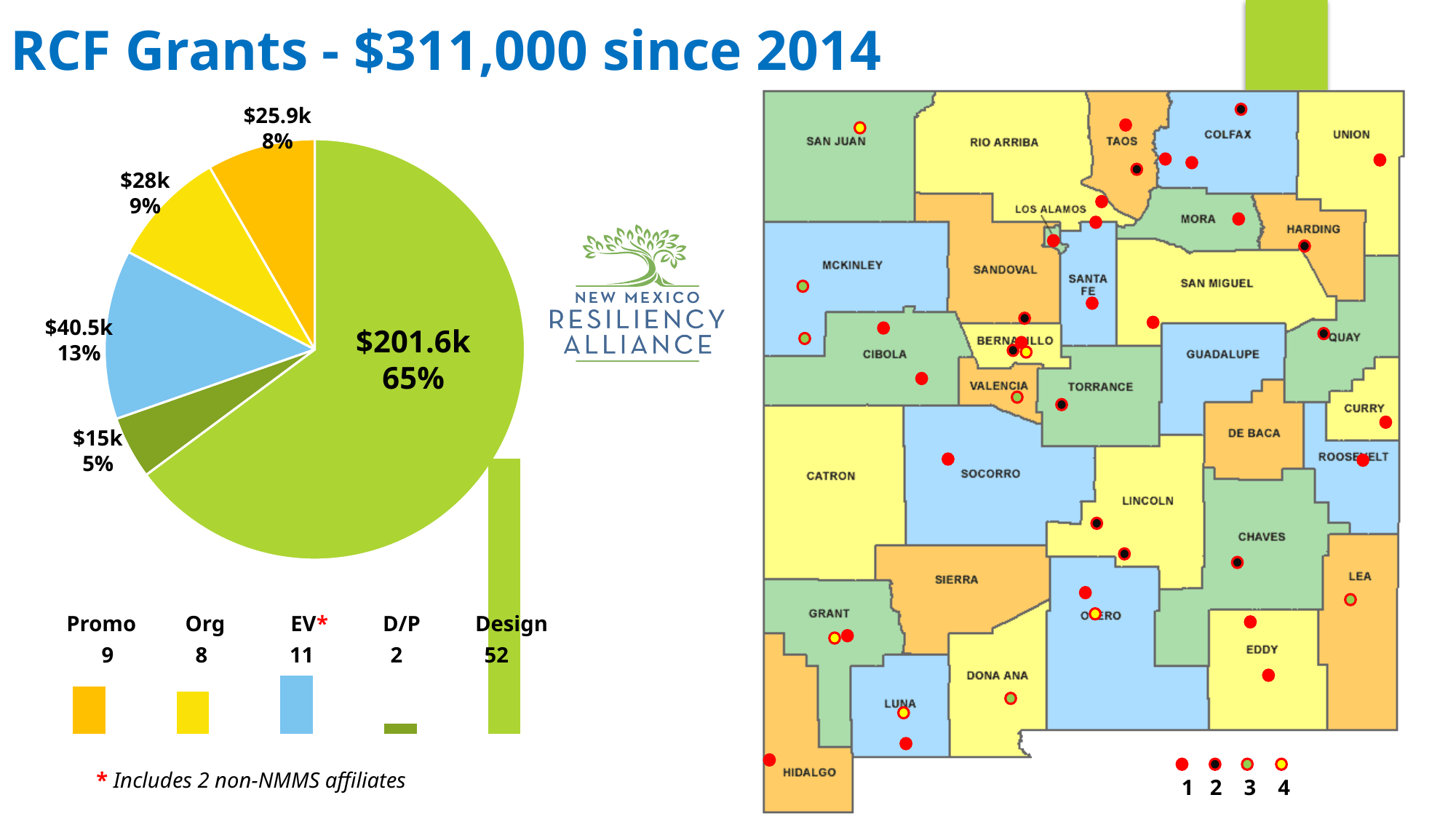
In the bar chart at the bottom left, which category has the lowest value? D/P In the pie chart, what percentage share does the largest slice have? 65% In the pie chart, what is the value of the largest slice? $201.6k In the bar chart at the bottom left, which is larger, Promo or Org? Promo What type of chart is shown at the top left of the slide? pie chart In the pie chart, what percentage share does the $40.5k slice have? 13% In the pie chart, what is the value of the smallest slice? $15k In the pie chart, what percentage share does the $28k slice have? 9% In the bar chart at the bottom left, what is the value for EV? 11 How many slices does the pie chart have? 5 In the pie chart, what is the difference between the $28k slice and the $25.9k slice? $2.1k In the bar chart at the bottom left, what is the value for Design? 52